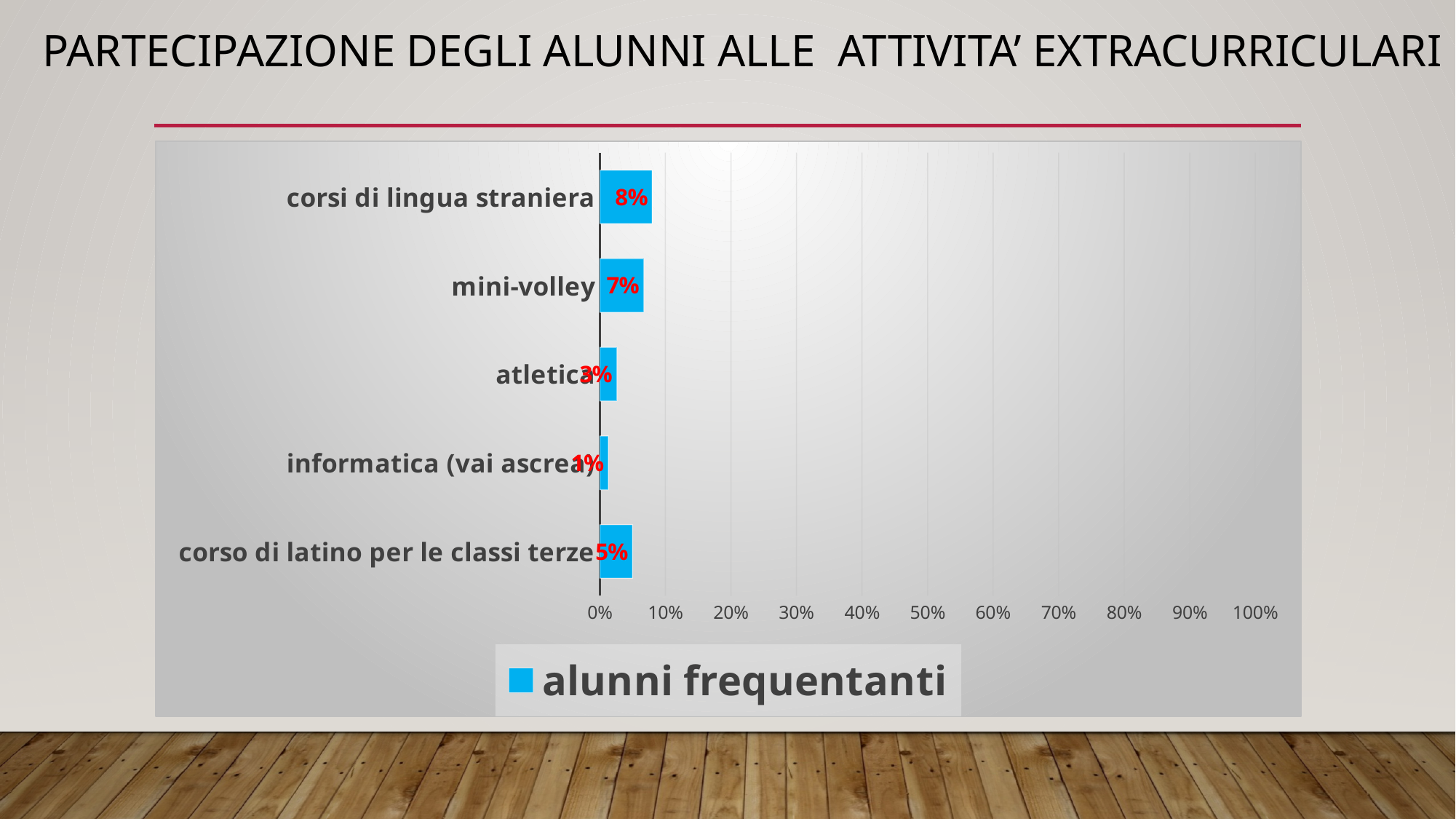
How many activities are shown in the chart? 5 What is the value shown for mini-volley? 7% Which activity has the lowest participation? informatica (vai ascrea) Which has a larger value, mini-volley or corso di latino per le classi terze? mini-volley What is the value shown for atletica? 3% What is the value shown for corso di latino per le classi terze? 5% Is the value for corsi di lingua straniera greater or less than 10%? less Which activity has the highest participation? corsi di lingua straniera What type of chart is shown on the slide? bar chart What is the difference between the values for corso di latino per le classi terze and atletica? 2% What percentage of students attended corsi di lingua straniera? 8% What is the difference between the values for corsi di lingua straniera and mini-volley? 1%